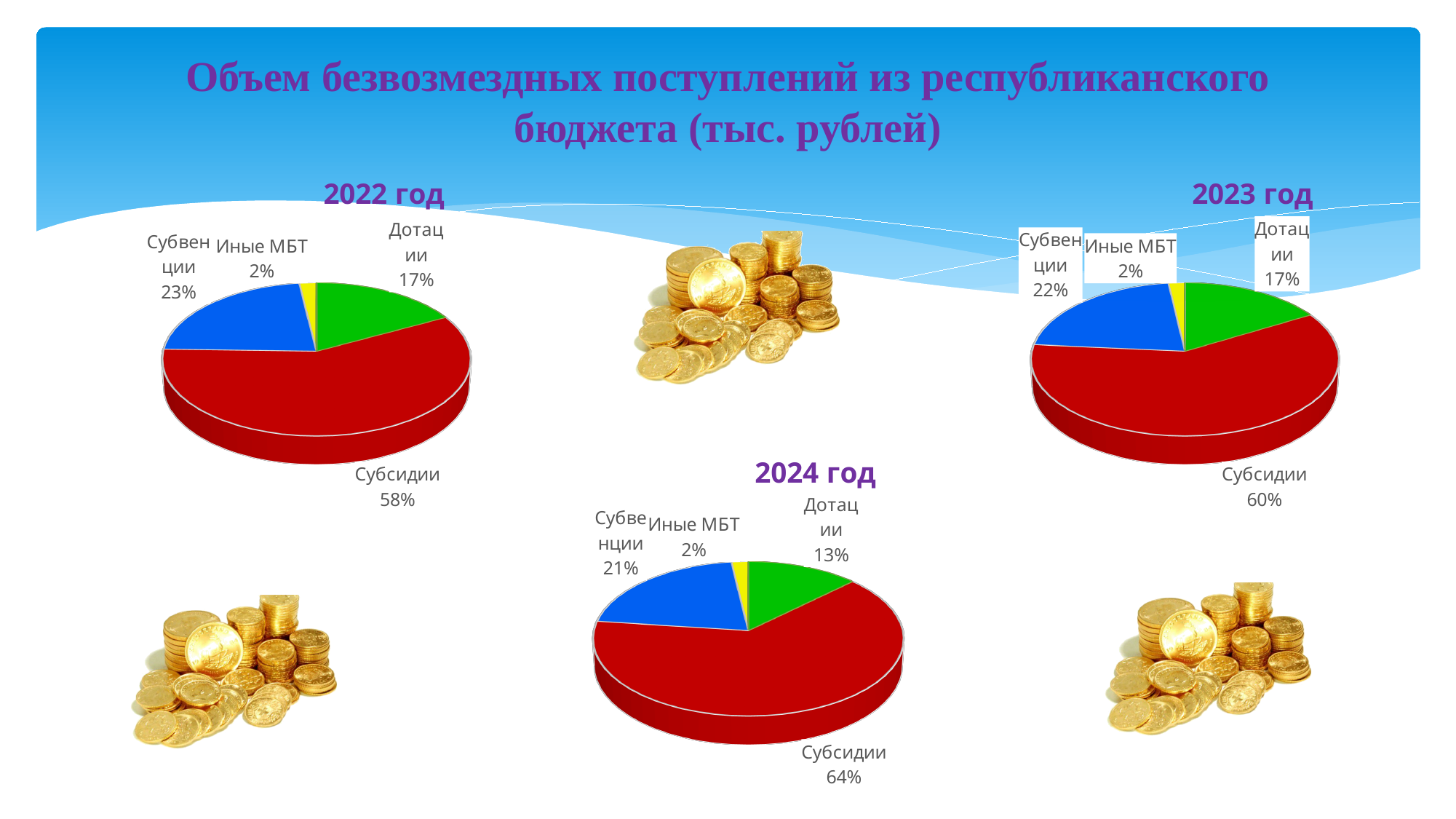
In the 2023 год pie chart, what share do Субвенции have? 22% In the 2023 год pie chart, what is the difference between the shares of Субсидии and Субвенции? 38% In the 2022 год pie chart, which is larger: Субвенции or Дотации? Субвенции In the 2024 год pie chart, what share do Дотации have? 13% What type of chart is used for 2023 год? Pie chart How many categories does the 2024 год pie chart show? 4 In the 2022 год pie chart, what share do Субсидии have? 58% In the 2022 год pie chart, which category has the smallest share? Иные МБТ How many pie charts are on the slide? 3 In the 2024 год pie chart, what colour is the Субсидии slice? Red In the 2024 год pie chart, which category has the largest share? Субсидии